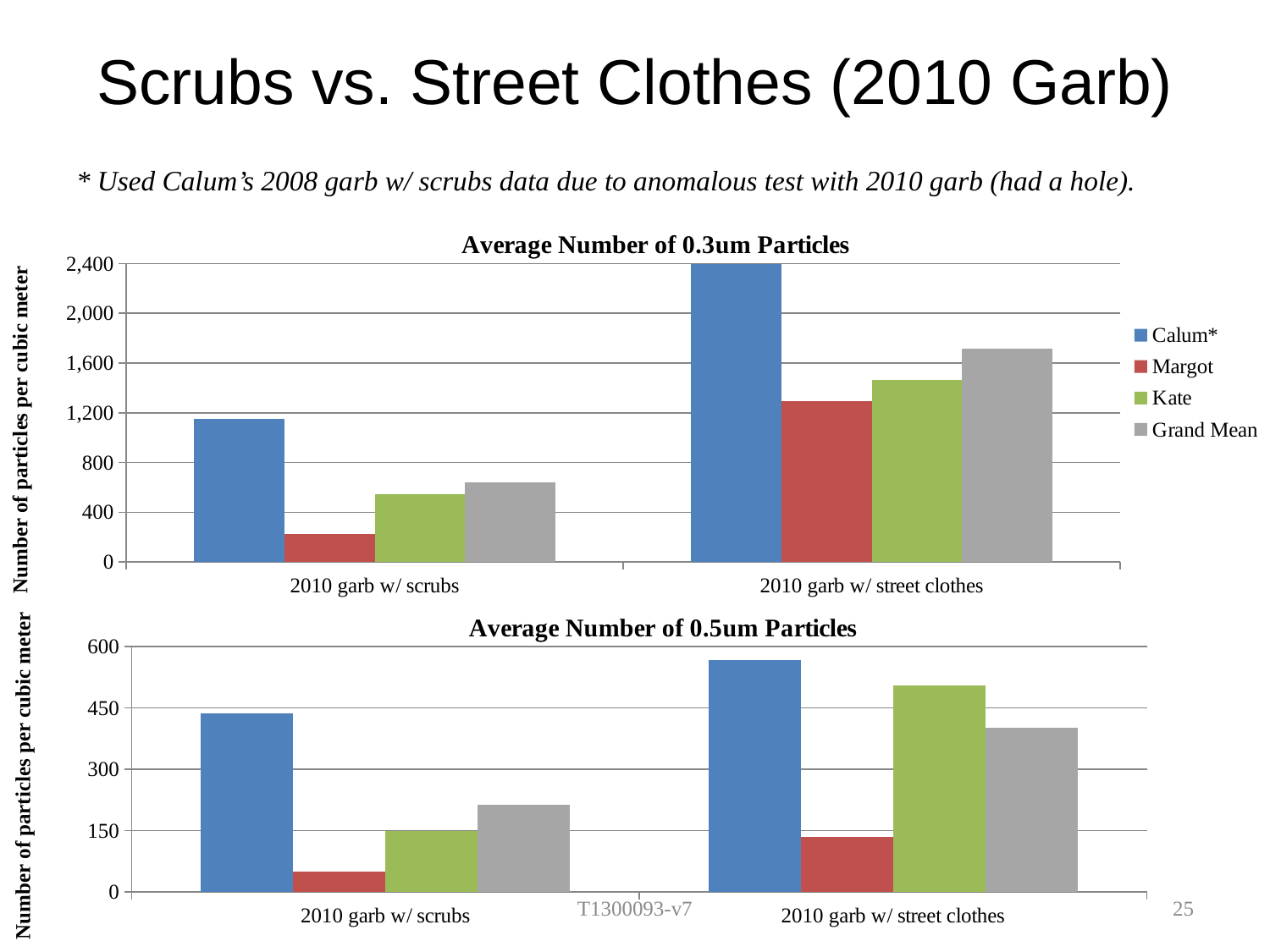
In the 'Average Number of 0.5um Particles' chart, is the value for Calum* under '2010 garb w/ street clothes' greater or less than 450? greater In the 'Average Number of 0.5um Particles' chart, which is larger for '2010 garb w/ street clothes': Kate or Grand Mean? Kate In the 'Average Number of 0.3um Particles' chart, is the value for Kate under '2010 garb w/ street clothes' greater or less than 1,200? greater How many series does the legend of the 'Average Number of 0.3um Particles' chart list? 4 In the 'Average Number of 0.3um Particles' chart, is the value for Margot under '2010 garb w/ scrubs' greater or less than 400? less How many categories are shown on the x axis of the 'Average Number of 0.5um Particles' chart? 2 In the 'Average Number of 0.3um Particles' chart, which series has the lowest value for '2010 garb w/ scrubs'? Margot What kind of chart is the 'Average Number of 0.3um Particles' chart? bar chart What is the label on the vertical axis of the 'Average Number of 0.5um Particles' chart? Number of particles per cubic meter In the 'Average Number of 0.3um Particles' chart, which series has the highest value for '2010 garb w/ street clothes'? Calum*